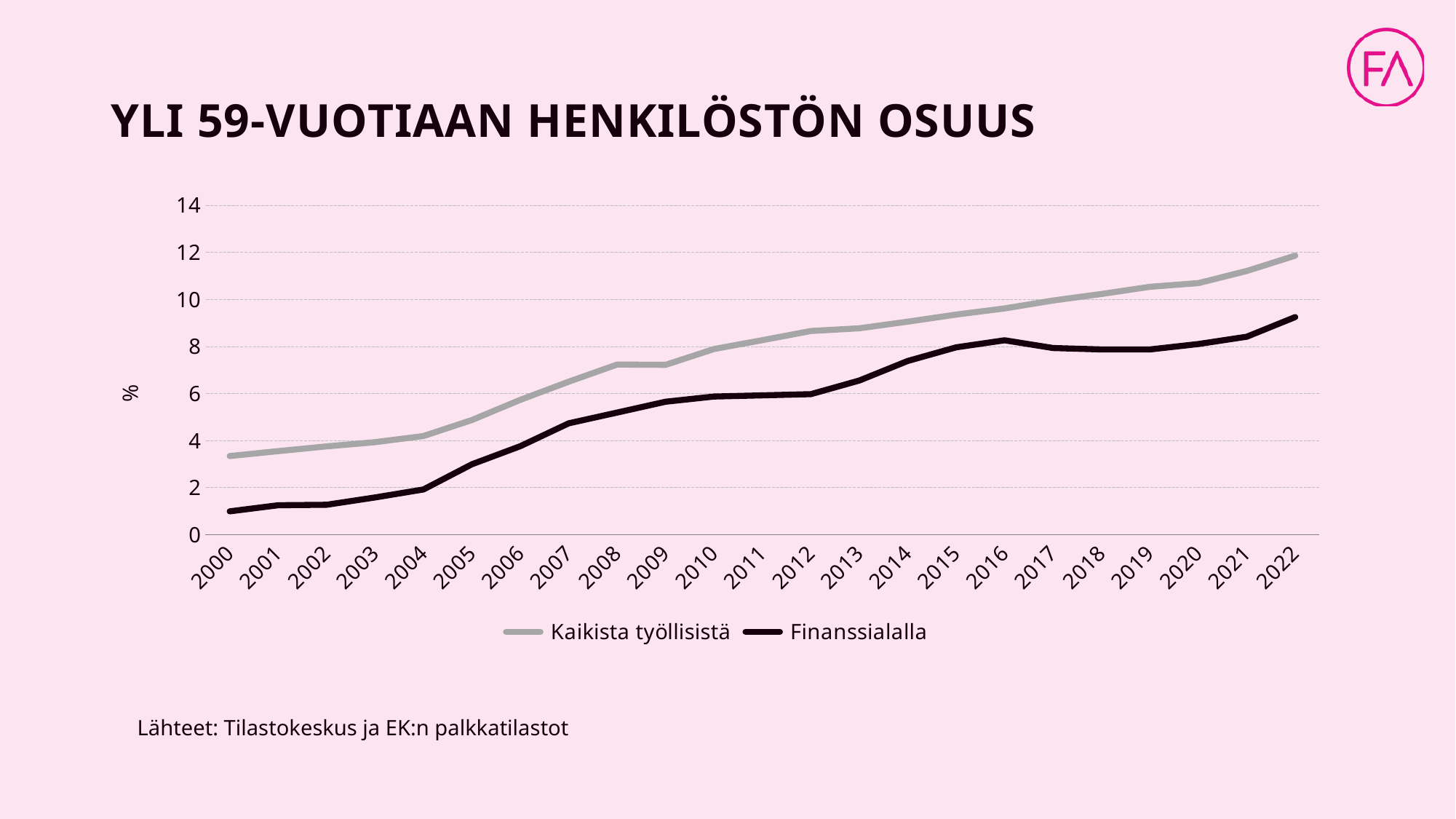
Is the value for Kaikista työllisistä in 2022 greater or less than 10? greater What kind of chart is shown on the slide? line chart Is the value for Finanssialalla in 2022 greater or less than 8? greater Is the value for Finanssialalla in 2000 greater or less than 2? less In which year is the Finanssialalla series at its lowest? 2000 How many series does the legend list? 2 Which series is higher in 2022, Kaikista työllisistä or Finanssialalla? Kaikista työllisistä Does the Kaikista työllisistä series generally rise or fall from 2000 to 2022? rise What is the title of the chart? YLI 59-VUOTIAAN HENKILÖSTÖN OSUUS How many years are plotted along the x axis? 23 In which year is the Kaikista työllisistä series at its highest? 2022